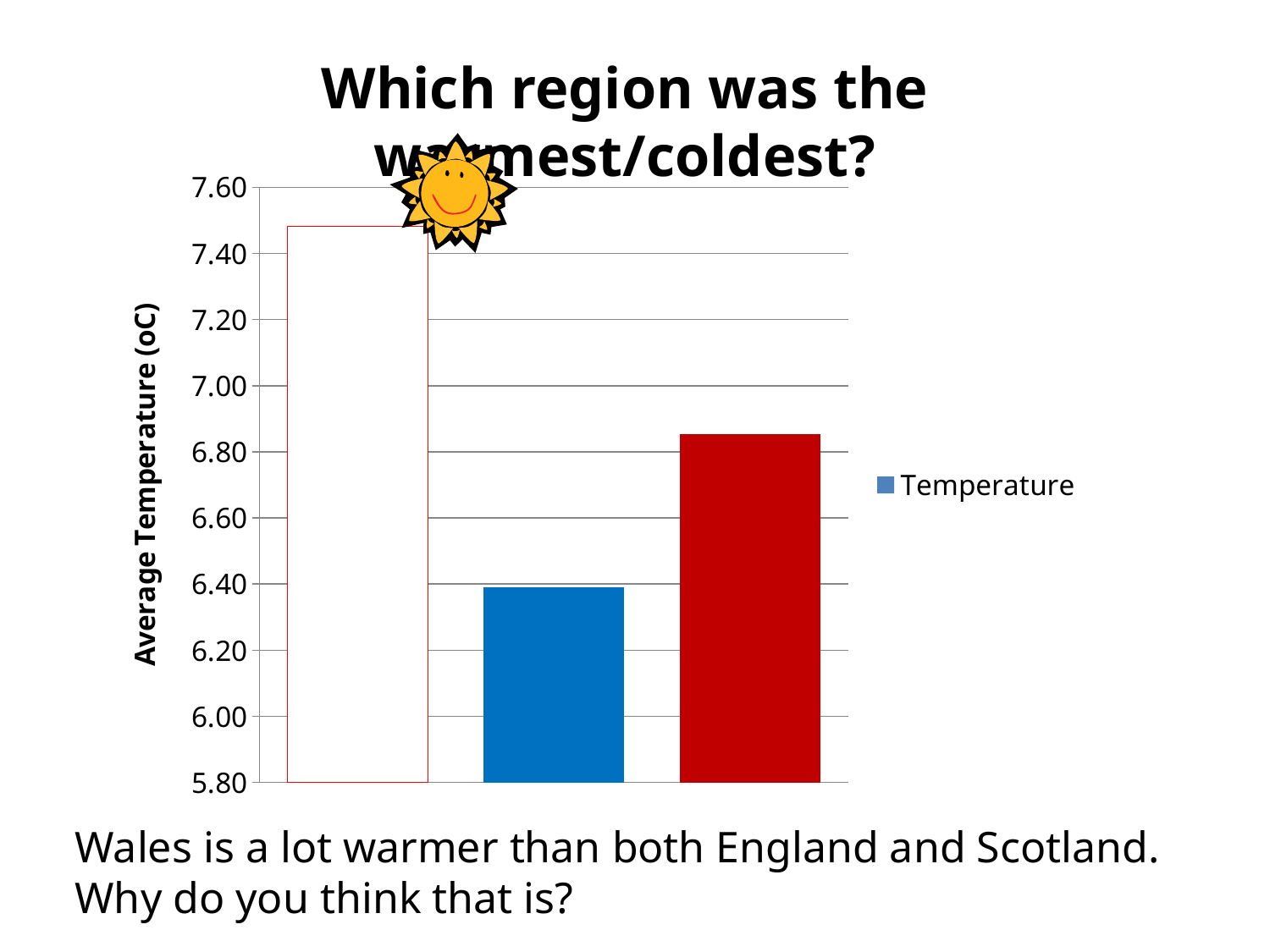
Which bar is the tallest in the chart: the left (white), middle (blue) or right (red) bar? the left (white) bar What is the name of the series shown in the chart legend? Temperature Which is larger, the value of the red bar or the value of the blue bar? the red bar Is the value of the right (red) bar greater or less than 6.60? greater Is the value of the middle (blue) bar greater or less than 6.60? less Is the value of the right (red) bar greater or less than 7.00? less What is the title of the vertical axis of the chart? Average Temperature (oC) How many series does the chart legend list? 1 How many bars are plotted in the chart? 3 What kind of chart is shown on the slide? bar chart Which bar is the shortest in the chart: the left (white), middle (blue) or right (red) bar? the middle (blue) bar